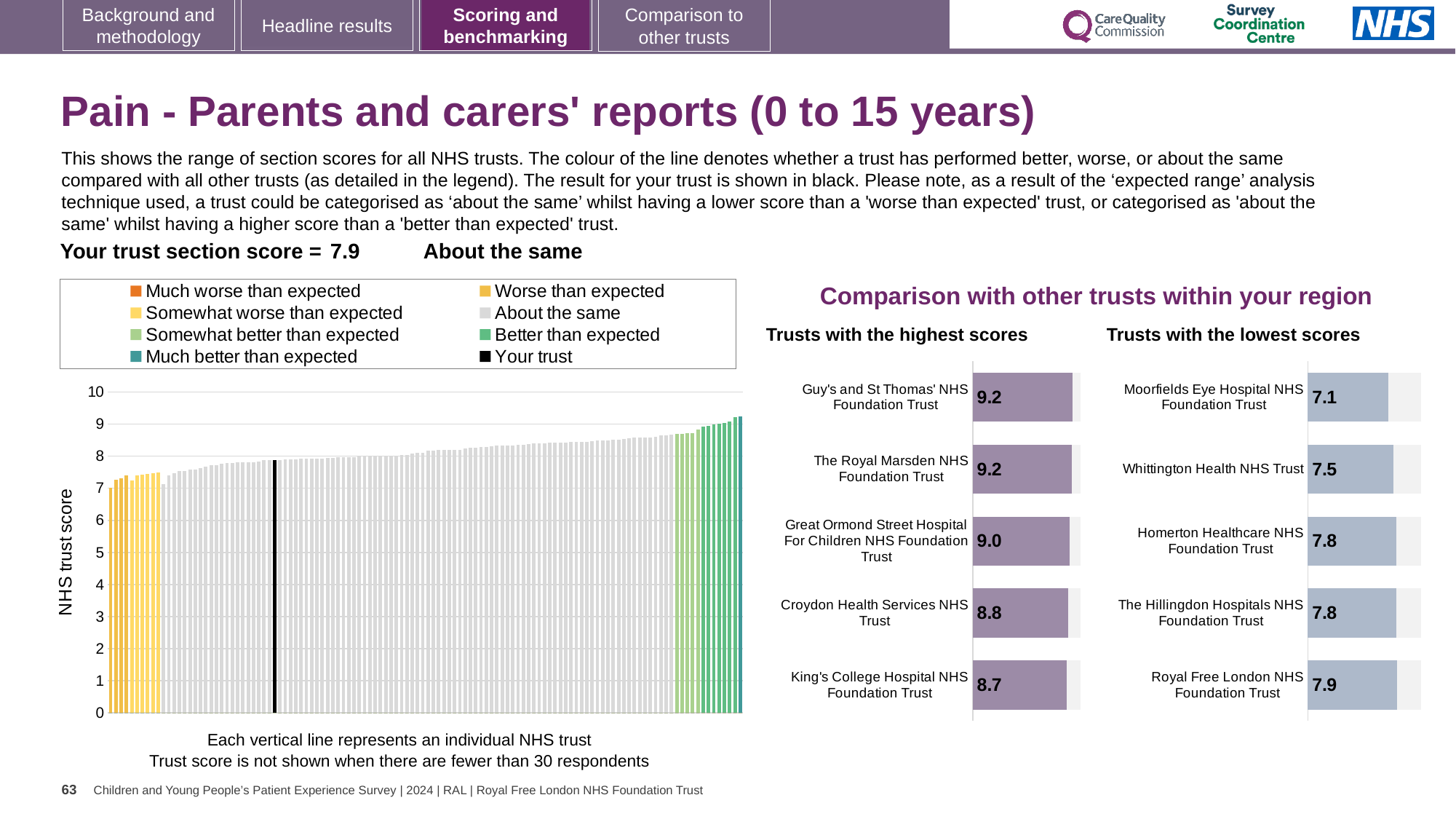
In the main chart on the left, is the value of the leftmost bar greater or less than 8? less In the 'Trusts with the highest scores' chart, what is the score for Croydon Health Services NHS Trust? 8.8 In the 'Trusts with the highest scores' chart, what is the score for Guy's and St Thomas' NHS Foundation Trust? 9.2 In the 'Trusts with the highest scores' chart, which has the higher score: Great Ormond Street Hospital For Children NHS Foundation Trust or Croydon Health Services NHS Trust? Great Ormond Street Hospital For Children NHS Foundation Trust In the 'Trusts with the lowest scores' chart, what is the score for Whittington Health NHS Trust? 7.5 In the 'Trusts with the highest scores' chart, what is the difference between the scores of Guy's and St Thomas' NHS Foundation Trust and King's College Hospital NHS Foundation Trust? 0.5 How many entries does the legend of the main chart on the left list? 8 In the main chart on the left, do the bar values rise or fall from left to right? rise In the 'Trusts with the lowest scores' chart, what is the difference between the scores of Royal Free London NHS Foundation Trust and Moorfields Eye Hospital NHS Foundation Trust? 0.8 In the 'Trusts with the highest scores' chart, which trust has the lowest score shown? King's College Hospital NHS Foundation Trust How many trusts are listed in the 'Trusts with the lowest scores' chart? 5 In the 'Trusts with the lowest scores' chart, which trust has the lowest score? Moorfields Eye Hospital NHS Foundation Trust